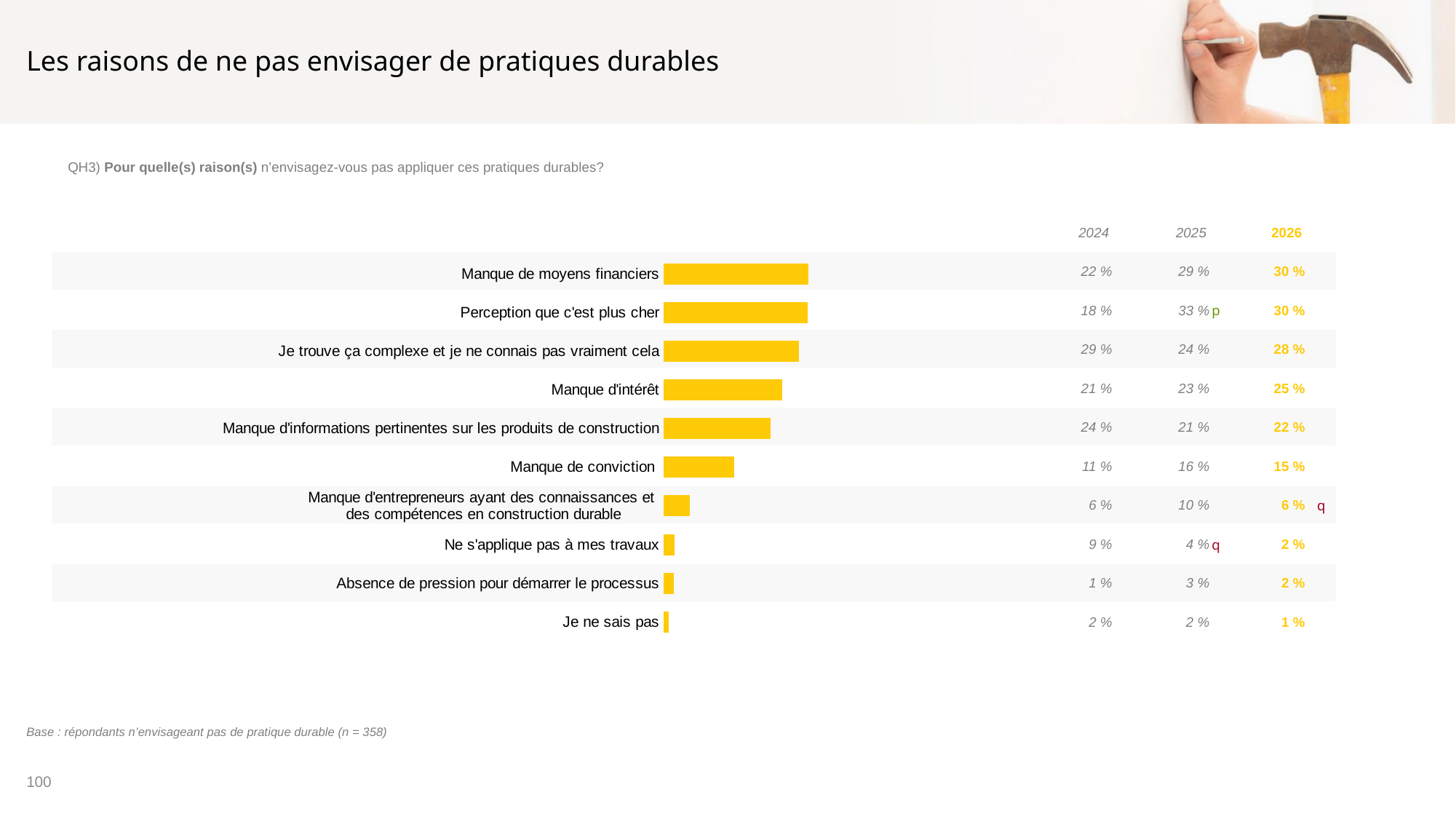
How many years (columns) of values are shown next to the chart? 3 What is the 2026 value for "Manque d'intérêt"? 25 % What is the difference between the 2026 values for "Manque de moyens financiers" and "Manque de conviction"? 15 % What is the 2024 value for "Je trouve ça complexe et je ne connais pas vraiment cela"? 29 % What kind of chart is shown on the slide? bar chart What is the base (n) of respondents indicated on the slide? n = 358 Which reason has the lowest 2026 value? Je ne sais pas How many reasons (categories) are listed in the chart? 10 What is the 2026 value for "Manque d'entrepreneurs ayant des connaissances et des compétences en construction durable"? 6 % Which has the larger 2026 value: "Manque d'intérêt" or "Manque d'informations pertinentes sur les produits de construction"? Manque d'intérêt What is the 2025 value for "Perception que c'est plus cher"? 33 % How did the value for "Manque de moyens financiers" change from 2024 to 2026? It rose from 22 % to 30 %